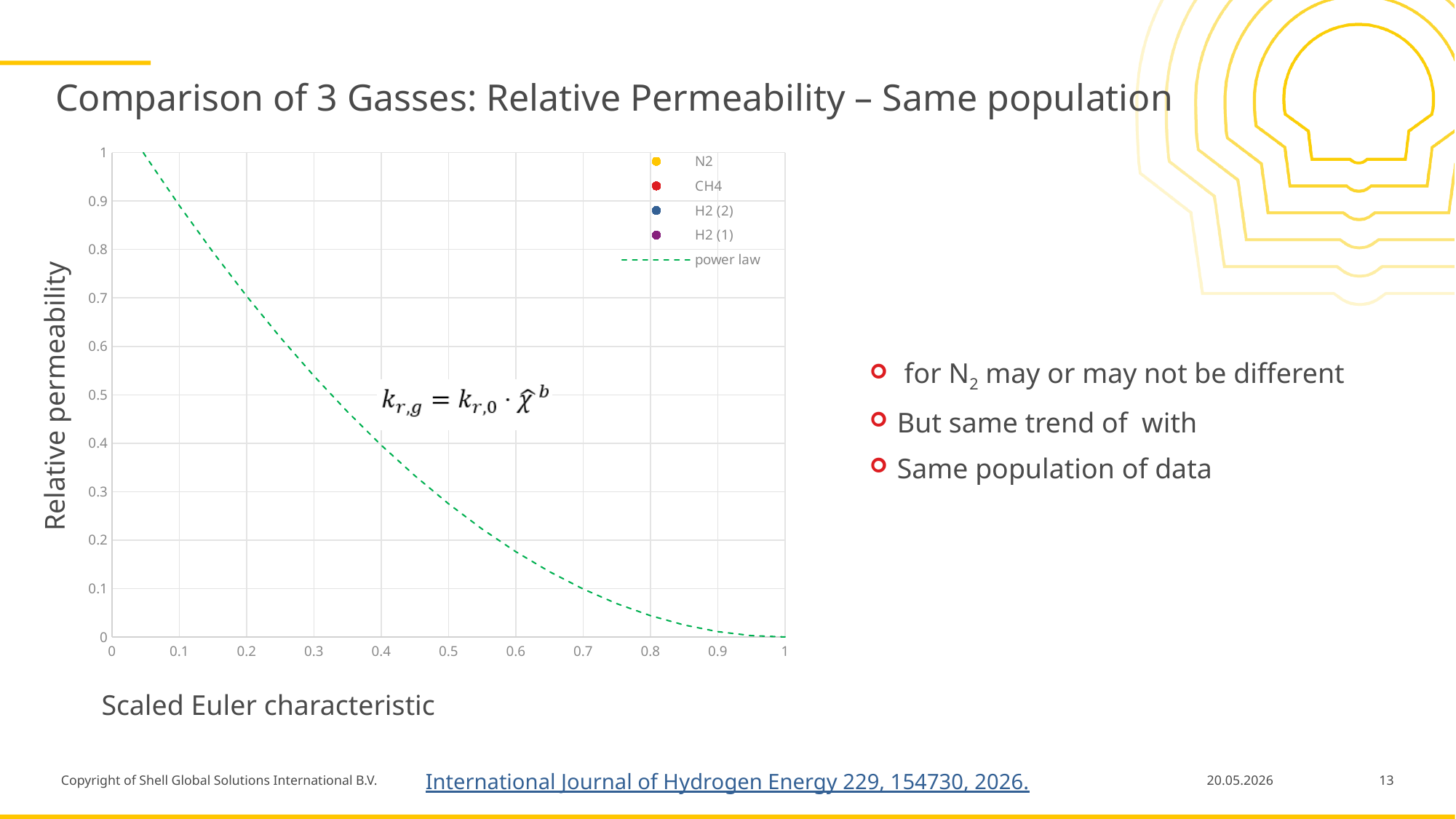
Is the power law value at a scaled Euler characteristic of 0.8 greater or less than 0.1? less What is the maximum value shown on the x axis of the chart? 1 Which is larger: the power law value at a scaled Euler characteristic of 0.2 or at 0.6? 0.2 Is the power law value at a scaled Euler characteristic of 0.9 greater or less than 0.1? less Is the power law value at a scaled Euler characteristic of 0.5 greater or less than 0.4? less Which legend entry is drawn as a dashed line? power law What is the label of the y axis? Relative permeability Does the power law curve rise or fall as the scaled Euler characteristic increases from 0 to 1? fall How many entries does the chart legend list? 5